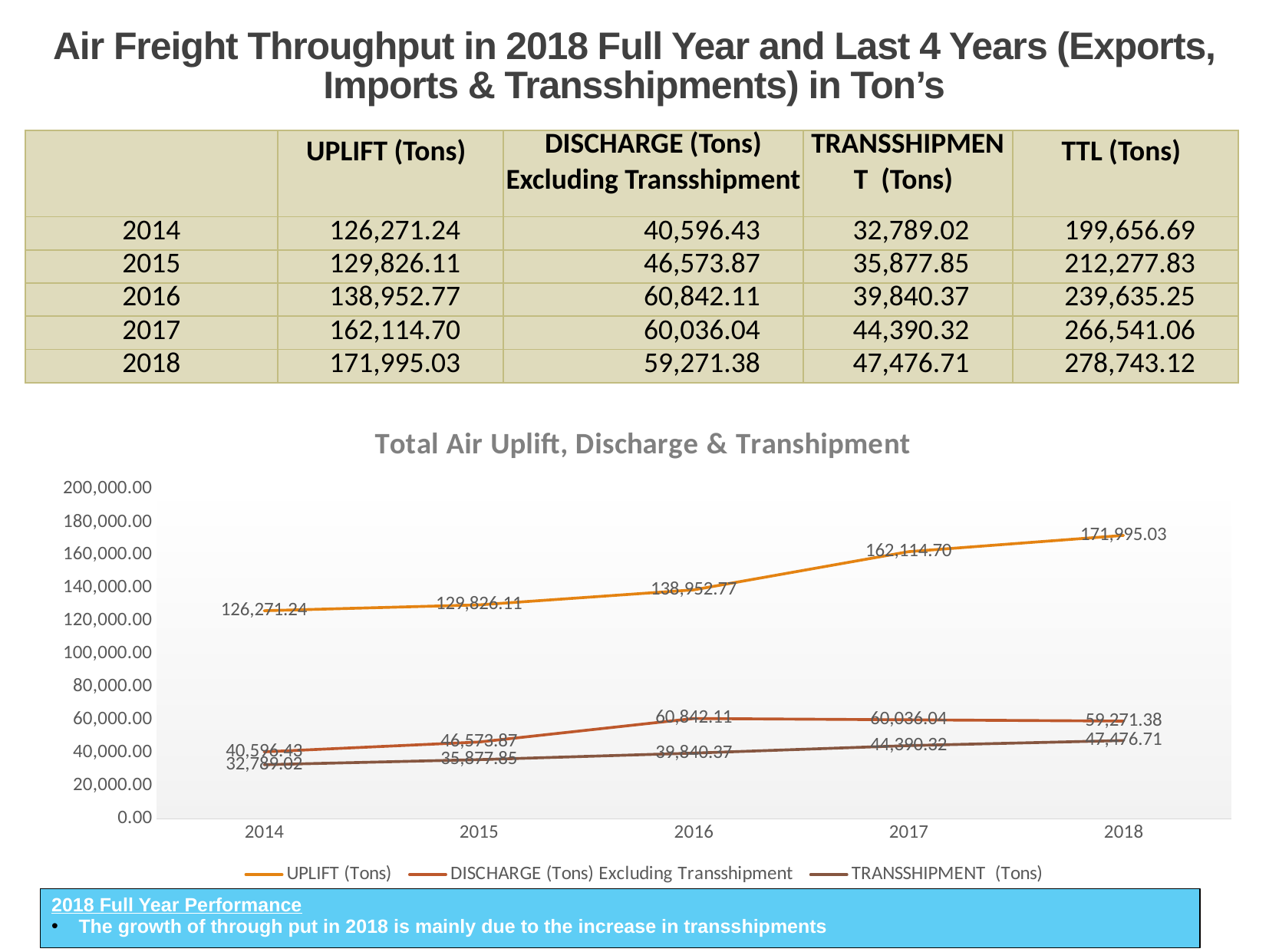
How many series does the chart legend list? 3 What type of chart is shown on the slide? line chart In which year is the TRANSSHIPMENT (Tons) series at its lowest? 2014 What is the title of the chart? Total Air Uplift, Discharge & Transhipment What is the TRANSSHIPMENT (Tons) value for 2015 in the chart? 35,877.85 How many years are plotted along the x axis of the chart? 5 What is the UPLIFT (Tons) value for 2018 in the chart? 171,995.03 In which year is the UPLIFT (Tons) series at its highest? 2018 Does the TRANSSHIPMENT (Tons) series rise or fall from 2014 to 2018? rise What is the DISCHARGE (Tons) Excluding Transshipment value for 2016 in the chart? 60,842.11 Which is larger in 2017: DISCHARGE (Tons) Excluding Transshipment or TRANSSHIPMENT (Tons)? DISCHARGE (Tons) Excluding Transshipment By how much did UPLIFT (Tons) increase from 2014 to 2018? 45,723.79